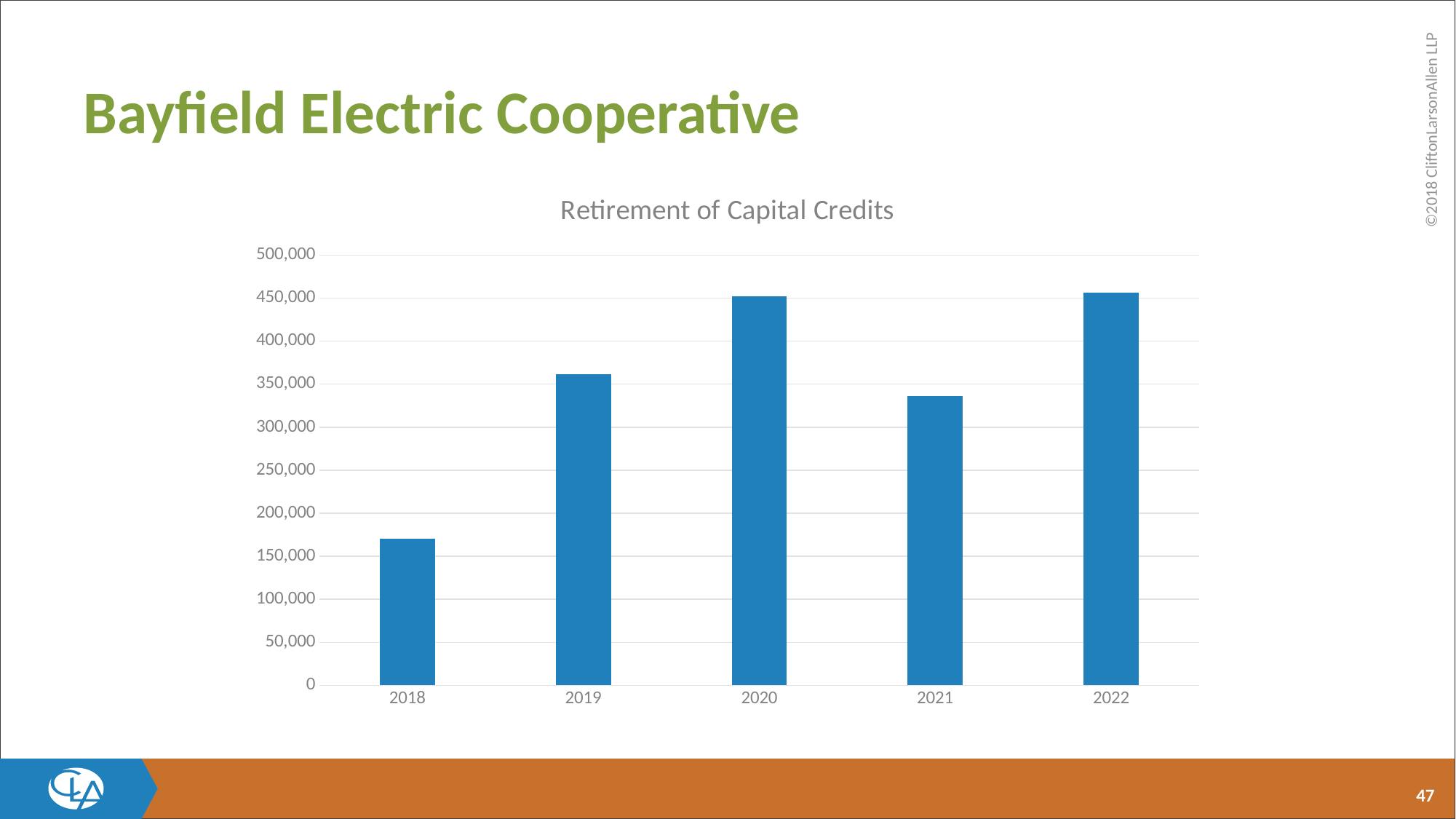
How many years are shown on the x axis of the chart? 5 What colour are the bars in the chart? Blue Is the value for 2018 greater or less than 200,000? less Is the value for 2019 greater or less than 300,000? greater What kind of chart is shown on the slide? Bar chart What is the title of the chart? Retirement of Capital Credits Which year has the larger value, 2020 or 2021? 2020 Is the value for 2021 greater or less than 300,000? greater Which year has the lowest retirement of capital credits? 2018 Does the value rise or fall from 2020 to 2021? fall